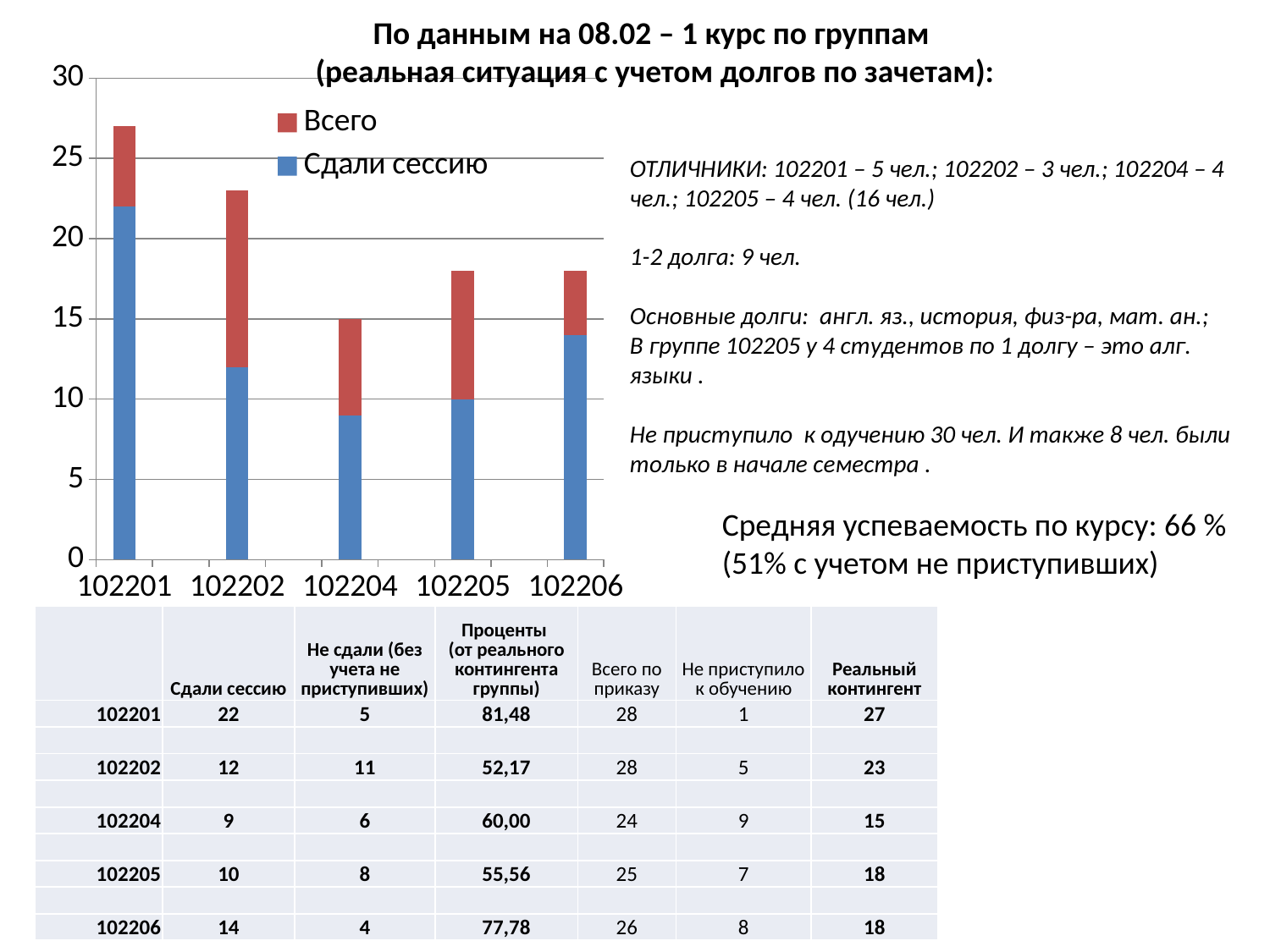
How many groups are shown on the x axis of the chart? 5 What is the value of 'Сдали сессию' for group 102201? 22 What is the value of 'Сдали сессию' for group 102205? 10 Which group has the lowest 'Сдали сессию' value? 102204 How many series does the chart legend list? 2 What are the two entries in the chart legend? Всего, Сдали сессию What kind of chart is shown on the slide? bar chart Which group has the highest 'Сдали сессию' value? 102201 Which group has the tallest bar overall in the chart? 102201 Is the top of the bar for group 102202 greater or less than 20? greater Is the 'Сдали сессию' value for group 102206 greater or less than 15? less Which group has the larger 'Сдали сессию' value, 102202 or 102206? 102206